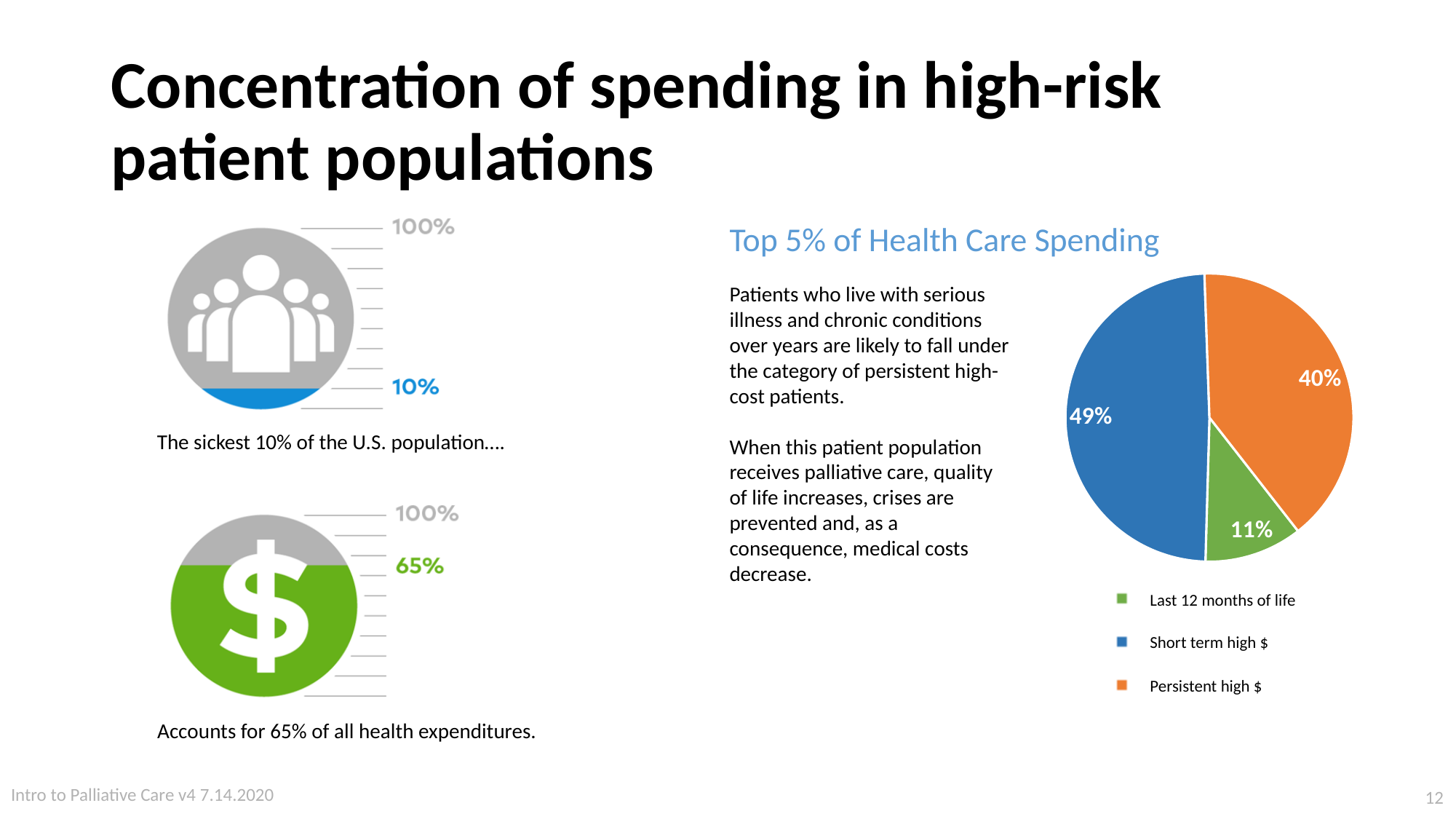
In the pie chart, what share of spending is labelled for "Persistent high $"? 40% In the pie chart, which is larger: "Persistent high $" or "Last 12 months of life"? Persistent high $ In the pie chart, what share of spending is labelled for "Short term high $"? 49% In the pie chart, what share of spending is labelled for "Last 12 months of life"? 11% What colour is the "Persistent high $" slice in the pie chart? orange In the pie chart, what is the difference in percentage points between "Short term high $" and "Persistent high $"? 9 What is the title of the pie chart? Top 5% of Health Care Spending How many slices does the pie chart have? 3 How many entries does the pie chart's legend list? 3 Which category has the smallest slice in the pie chart? Last 12 months of life What kind of chart is shown under the title "Top 5% of Health Care Spending"? pie chart Which category has the largest slice in the pie chart? Short term high $